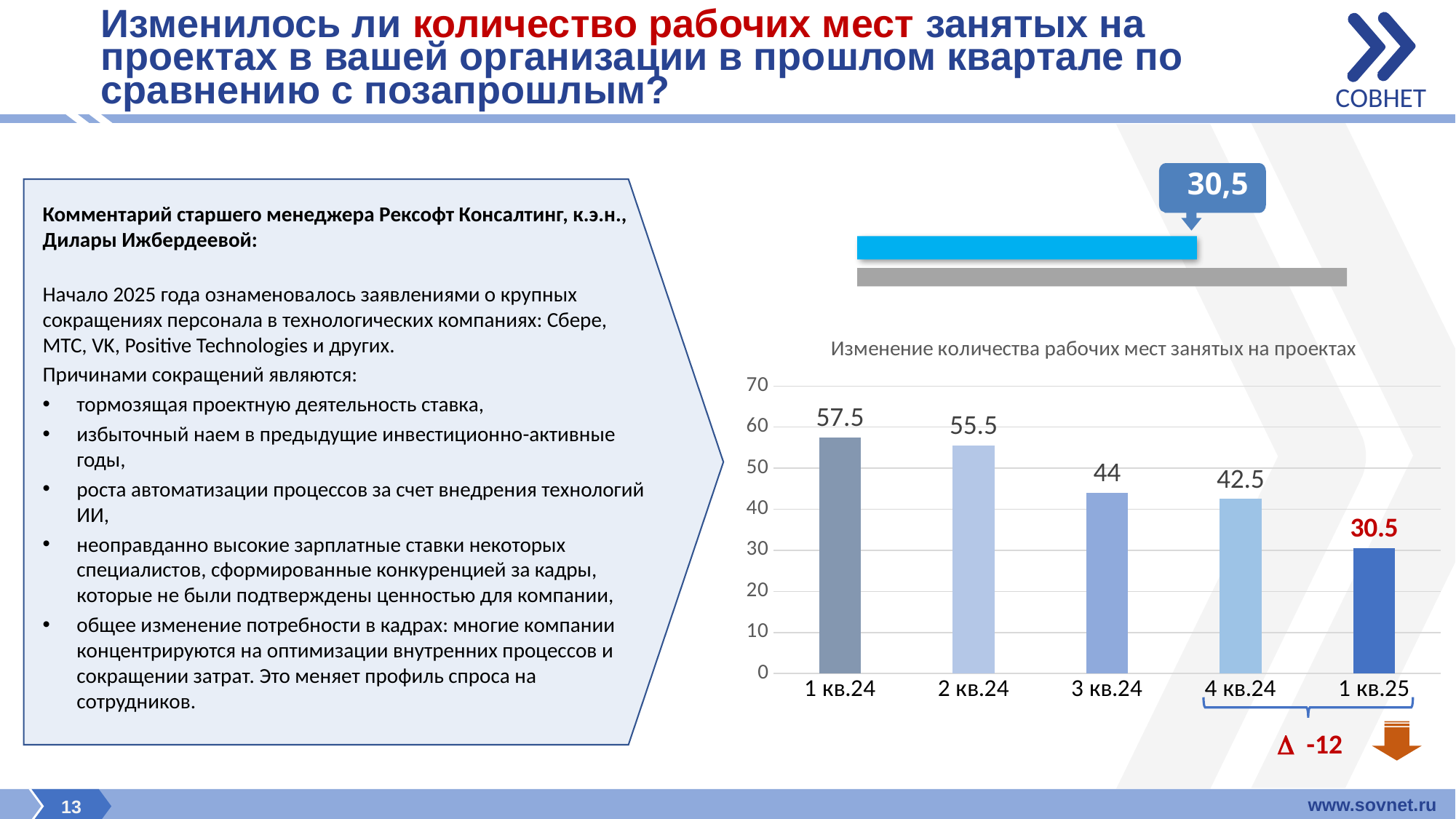
Which quarter has the lowest value in the chart? 1 кв.25 What is the difference between the values for 4 кв.24 and 1 кв.25? 12 Do the values rise or fall from 1 кв.24 to 1 кв.25? Fall What kind of chart is used to show the change in the number of project jobs? Bar chart Which is larger, the value for 2 кв.24 or the value for 3 кв.24? 2 кв.24 What is the value for 4 кв.24 in the chart? 42.5 What is the difference between the values for 1 кв.24 and 2 кв.24? 2 What is the value for 1 кв.24 in the chart "Изменение количества рабочих мест занятых на проектах"? 57.5 What is the value for 3 кв.24 in the chart? 44 Which quarter has the highest value in the chart? 1 кв.24 What is the value for 1 кв.25 in the chart? 30.5 How many quarters are shown on the x axis of the chart? 5